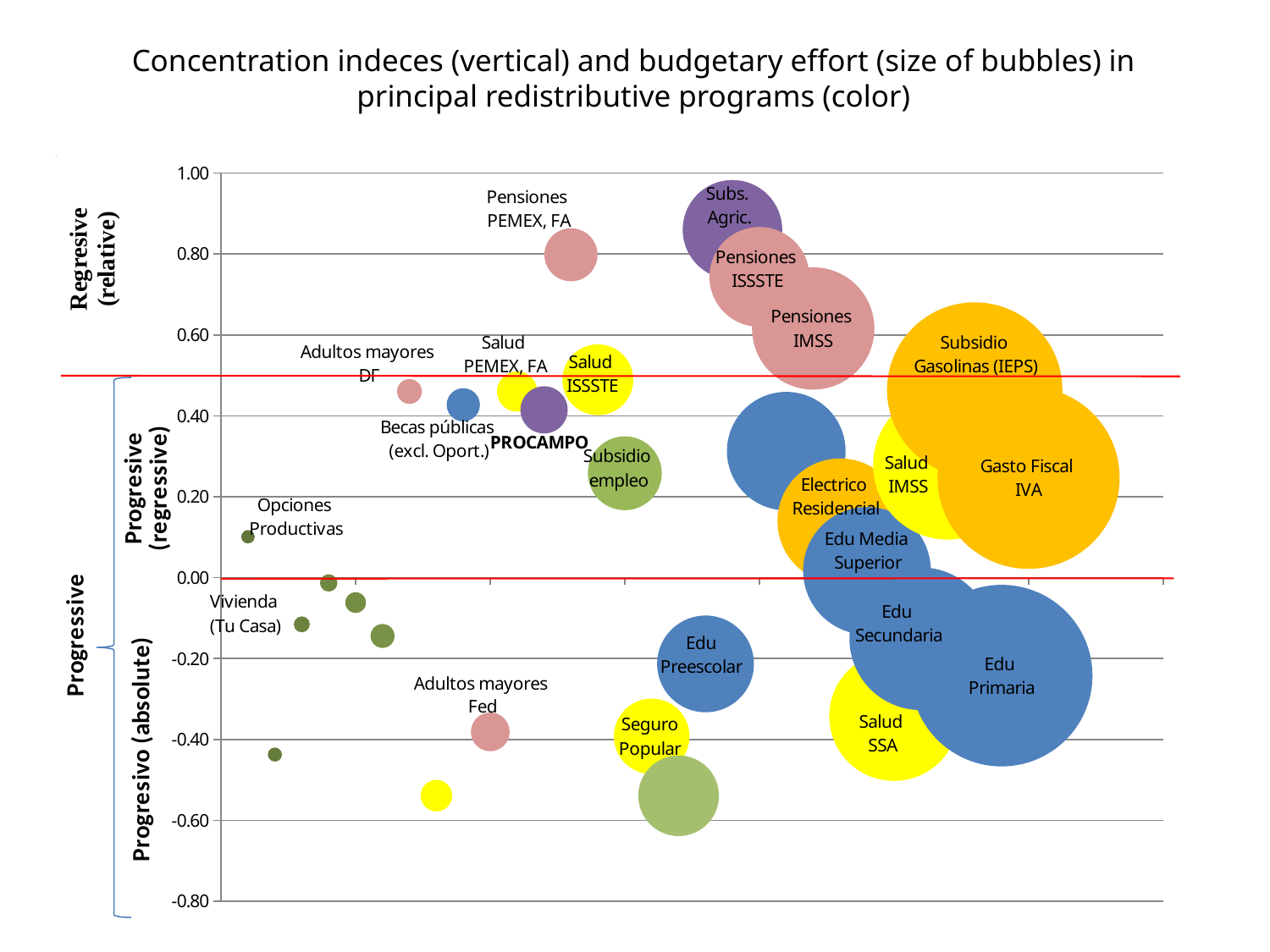
Which labeled program has the highest concentration index on the vertical axis? Subs. Agric. Which has a higher concentration index, Subs. Agric. or Edu Primaria? Subs. Agric. Is the concentration index for Subsidio empleo greater or less than 0.00? greater Is the concentration index for Adultos mayores Fed greater or less than -0.20? less Is the concentration index for Edu Primaria greater or less than 0.00? less Which has a higher concentration index, Pensiones IMSS or Gasto Fiscal IVA? Pensiones IMSS What is the title of the chart? Concentration indeces (vertical) and budgetary effort (size of bubbles) in principal redistributive programs (color) What kind of chart is shown on the slide? bubble chart